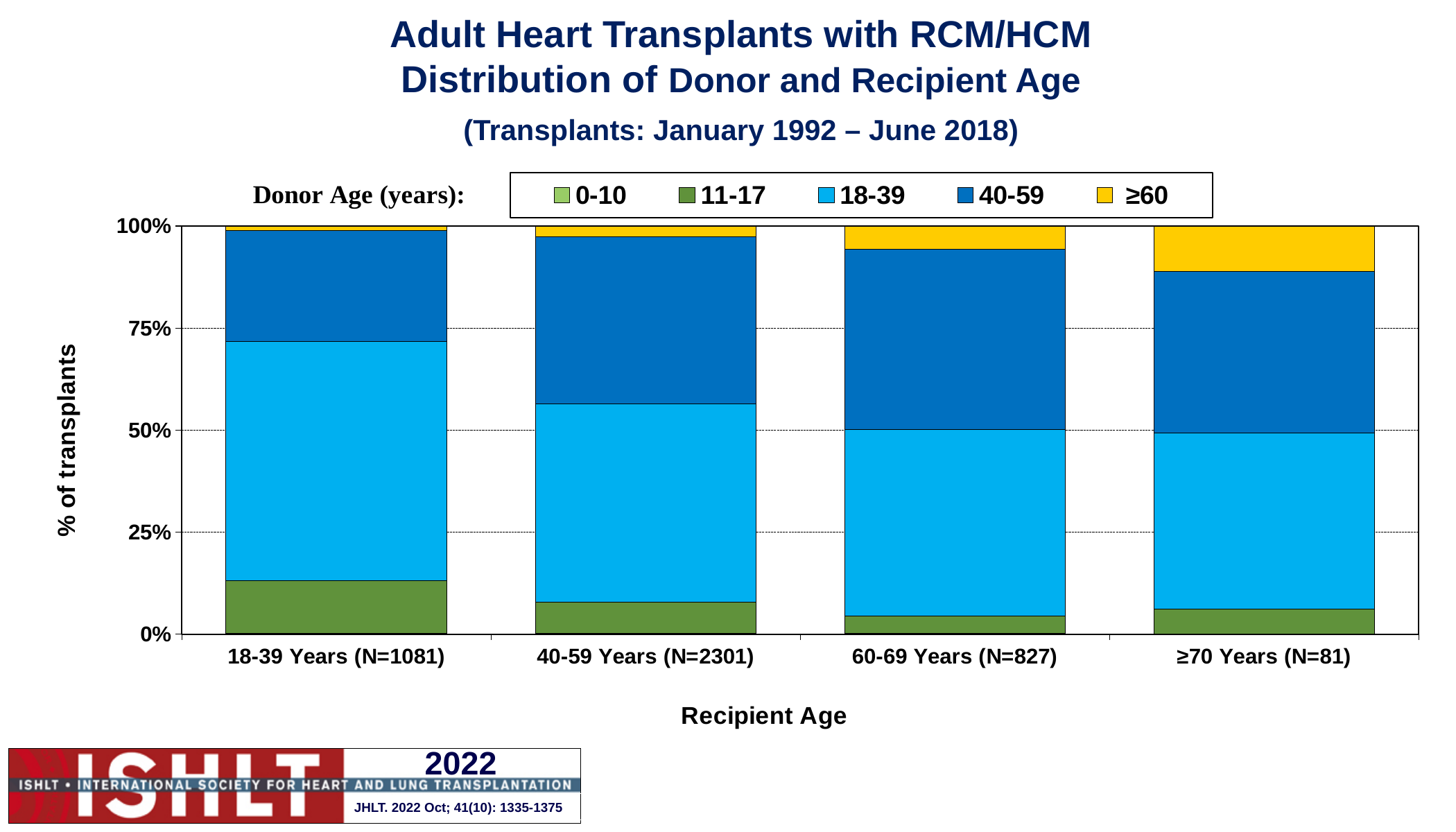
Which recipient age group has the largest share of donors aged 11-17? 18-39 Years (N=1081) For recipients aged 40-59 Years, is the top of the 18-39 donor segment greater or less than 50%? greater What is the total of each stacked bar? 100% Which recipient age group has the largest share of donors aged ≥60? ≥70 Years (N=81) For recipients aged 18-39 Years, is the share of donors aged 11-17 greater or less than 25%? less What is the N shown for the 40-59 Years recipient age group? N=2301 What kind of chart is shown on the slide? Stacked bar chart How many donor age series does the legend list? 5 Which recipient age group has the smallest share of donors aged ≥60? 18-39 Years (N=1081) Does the share of donors aged ≥60 rise or fall as recipient age increases along the x axis? Rise For recipients aged 18-39 Years, which donor age segment is larger: 18-39 or 40-59? 18-39 How many recipient age categories are shown on the x axis? 4